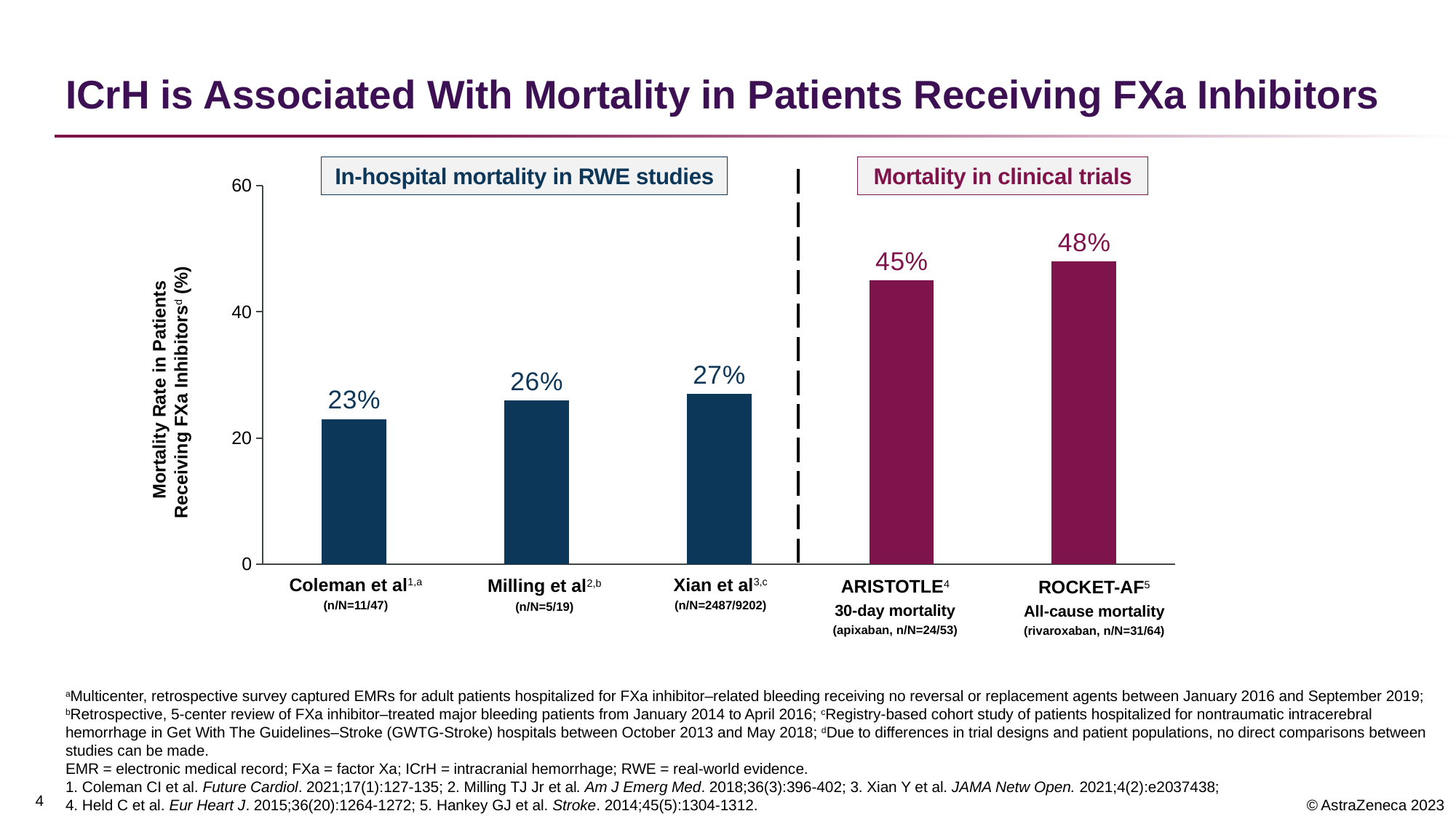
What is the label of the y axis? Mortality Rate in Patients Receiving FXa Inhibitors (%) Which study or trial has the highest mortality rate on the chart? ROCKET-AF How many bars are plotted on the chart? 5 What is the mortality rate shown for ROCKET-AF? 48% What is the mortality rate shown for Coleman et al? 23% Is the value for ROCKET-AF greater or less than 40? greater What is the mortality rate shown for Xian et al? 27% Which has a higher mortality rate, Xian et al or ARISTOTLE? ARISTOTLE Do the mortality values rise or fall from left to right across the chart? Rise Which study or trial has the lowest mortality rate on the chart? Coleman et al What is the difference in mortality rate between ARISTOTLE and Milling et al? 19% What kind of chart is shown on the slide? Bar chart